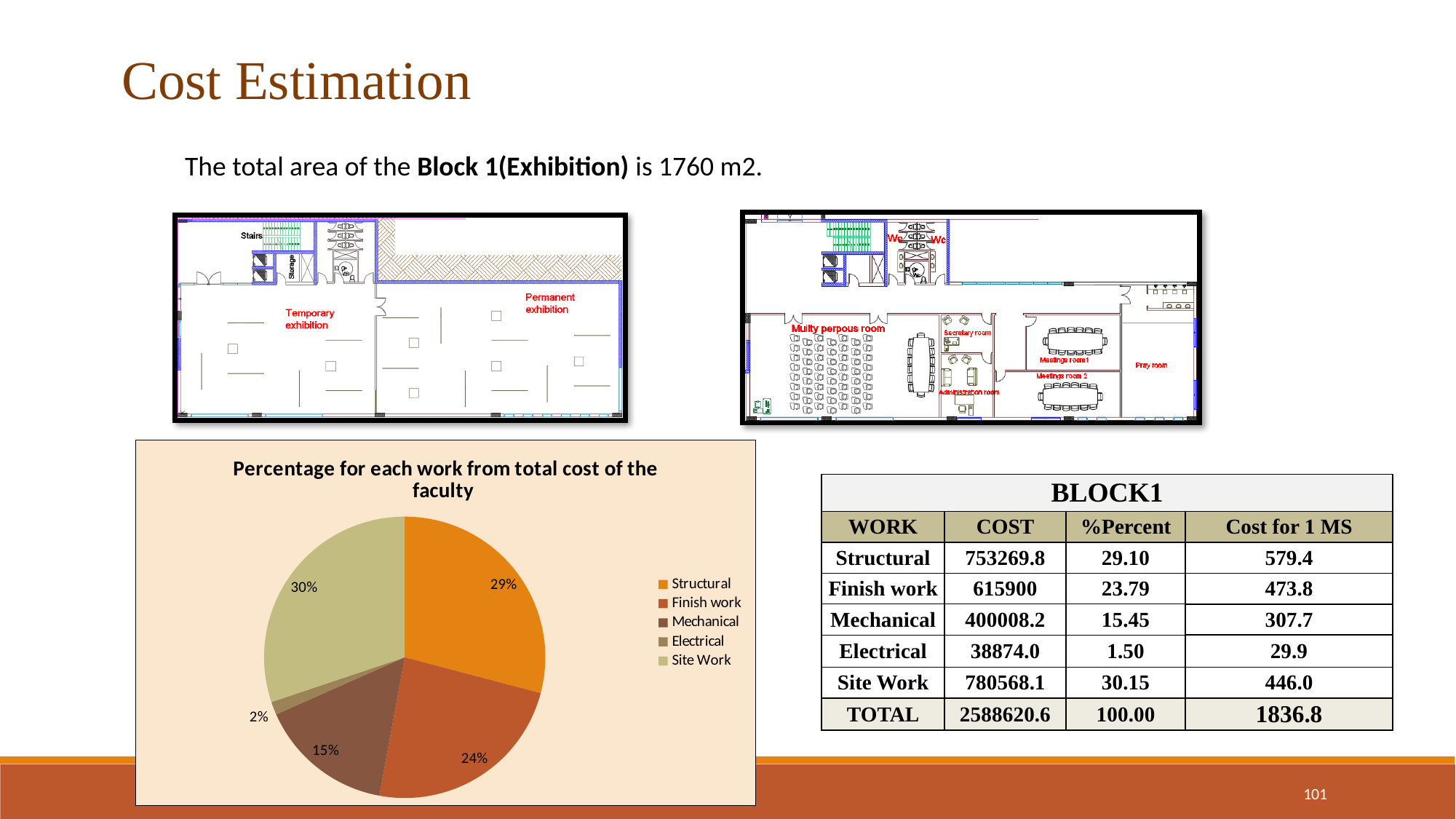
What percentage does the Mechanical slice show in the pie chart? 15% What percentage does the Finish work slice show in the pie chart? 24% In the pie chart, which is larger: the Finish work share or the Mechanical share? Finish work How many categories does the legend of the pie chart list? 5 What is the difference in percentage points between the Structural and Mechanical slices in the pie chart? 14% What kind of chart is shown on the slide? pie chart What percentage does the Electrical slice show in the pie chart? 2% What is the title of the pie chart? Percentage for each work from total cost of the faculty What percentage does the Site Work slice show in the pie chart? 30% What percentage does the Structural slice show in the pie chart? 29% Which work category has the smallest share in the pie chart? Electrical Which work category has the largest share in the pie chart? Site Work